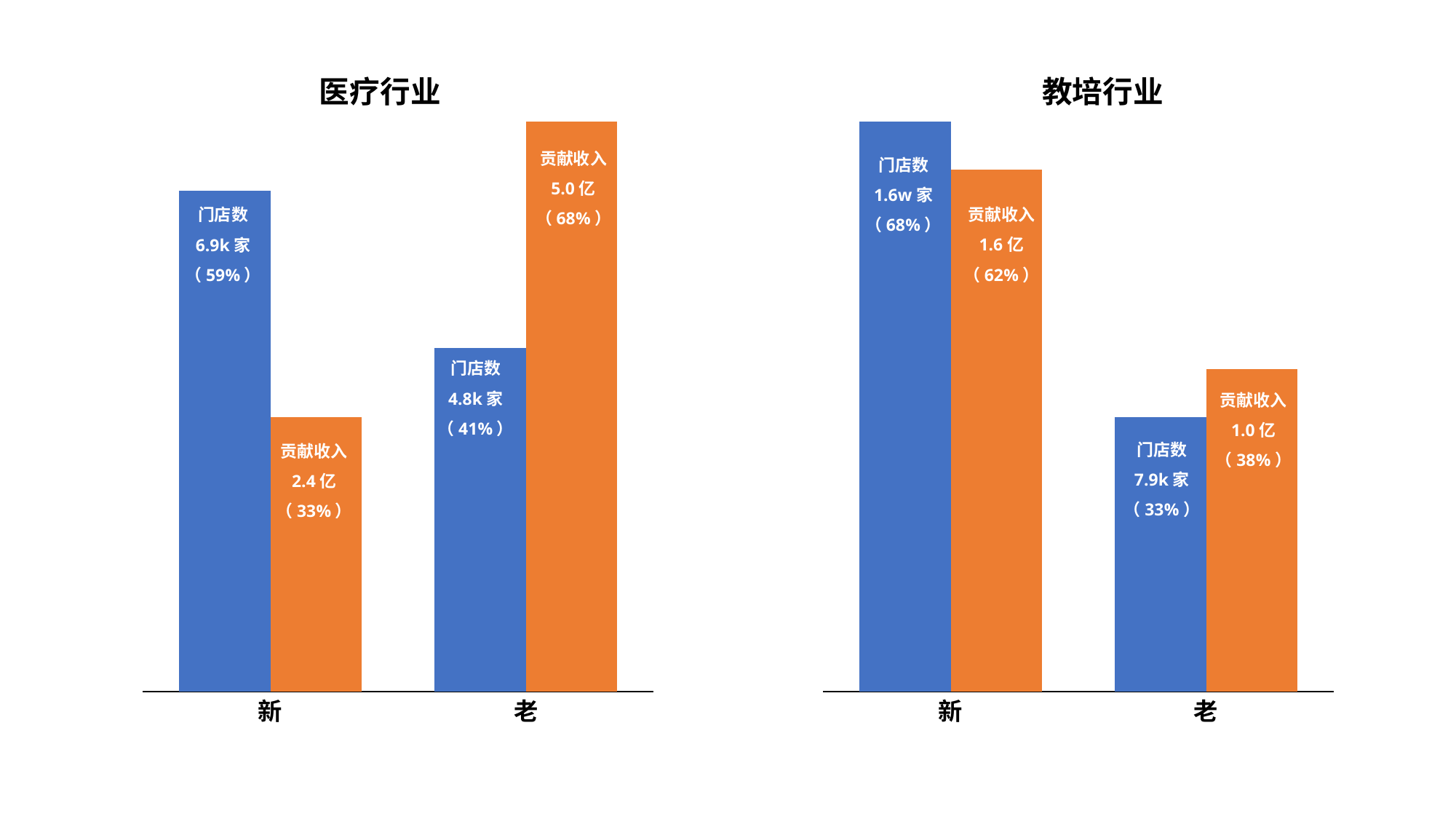
In the 医疗行业 chart, which category has the higher 贡献收入, 新 or 老? 老 In the 教培行业 chart, what percentage is shown for 门店数 of 老? 33% In the 医疗行业 chart, what is the 贡献收入 value for 老? 5.0 亿 In the 教培行业 chart, what is the difference in 贡献收入 between 新 and 老? 0.6 亿 In the 教培行业 chart, what is the 门店数 value for 新? 1.6w 家 In the 医疗行业 chart, what percentage is shown for 贡献收入 of 新? 33% In the 教培行业 chart, what is the 贡献收入 value for 老? 1.0 亿 In the 教培行业 chart, which category has the higher 门店数, 新 or 老? 新 In the 医疗行业 chart, what is the difference in 贡献收入 between 老 and 新? 2.6 亿 How many categories are shown on the x axis of the 医疗行业 chart? 2 What type of chart is the 教培行业 chart? Bar chart In the 医疗行业 chart, what is the 门店数 value for 新? 6.9k 家